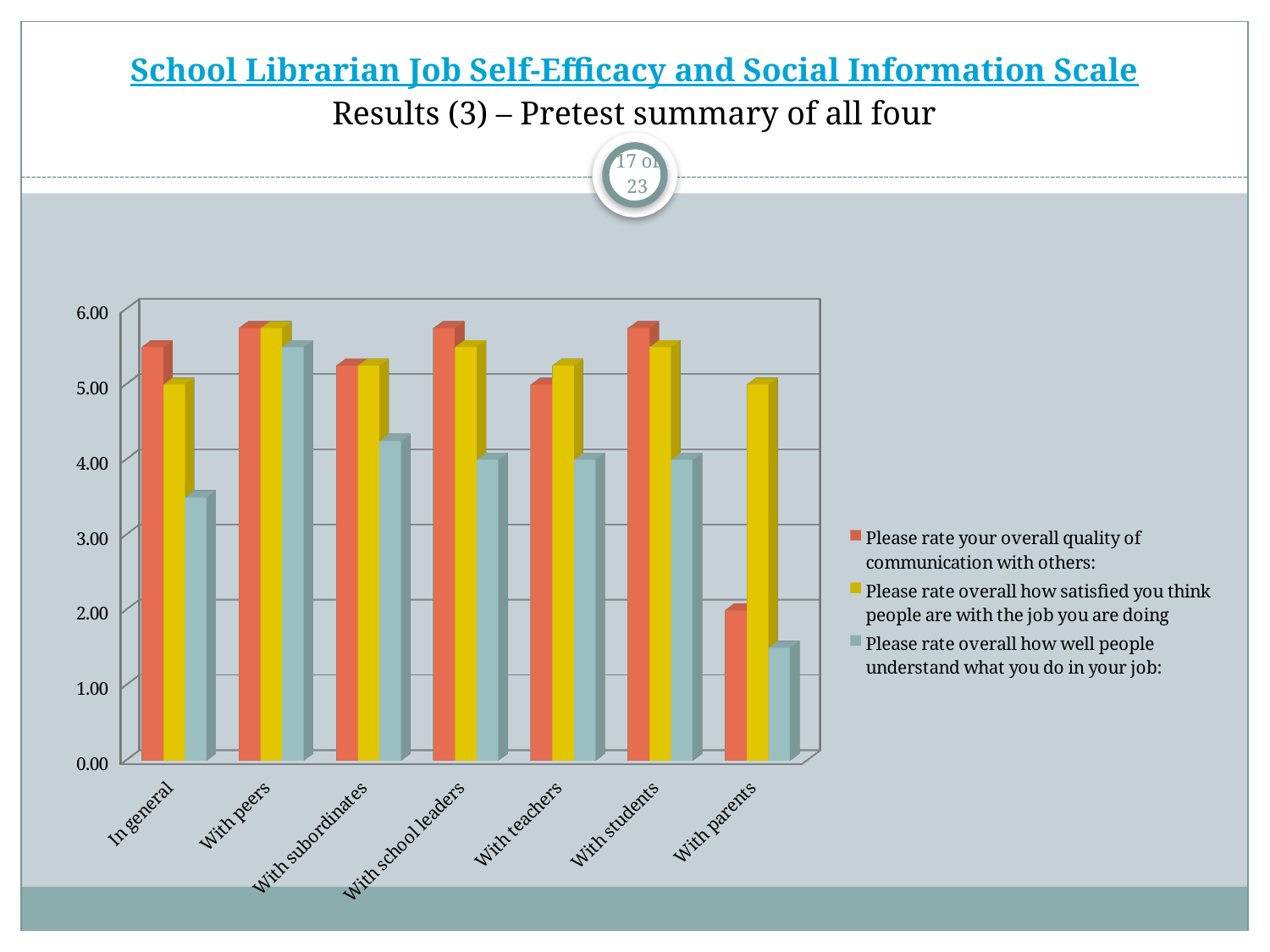
Is the value for 'With peers' in the series 'Please rate your overall quality of communication with others:' greater or less than 5.00? greater How many categories are shown along the x axis of the chart? 7 What kind of chart is shown on the slide? bar chart For 'With parents', which is larger: the value for 'Please rate your overall quality of communication with others:' or the value for 'Please rate overall how satisfied you think people are with the job you are doing'? Please rate overall how satisfied you think people are with the job you are doing Which category has the lowest value for the series 'Please rate overall how well people understand what you do in your job:'? With parents What is the highest value shown on the chart's vertical axis? 6.00 Which category has the lowest value for the series 'Please rate your overall quality of communication with others:'? With parents For 'In general', which is larger: the value for 'Please rate your overall quality of communication with others:' or the value for 'Please rate overall how well people understand what you do in your job:'? Please rate your overall quality of communication with others: Is the value for 'In general' in the series 'Please rate overall how well people understand what you do in your job:' greater or less than 4.00? less Is the value for 'With parents' in the series 'Please rate your overall quality of communication with others:' greater or less than 3.00? less How many series does the chart's legend list? 3